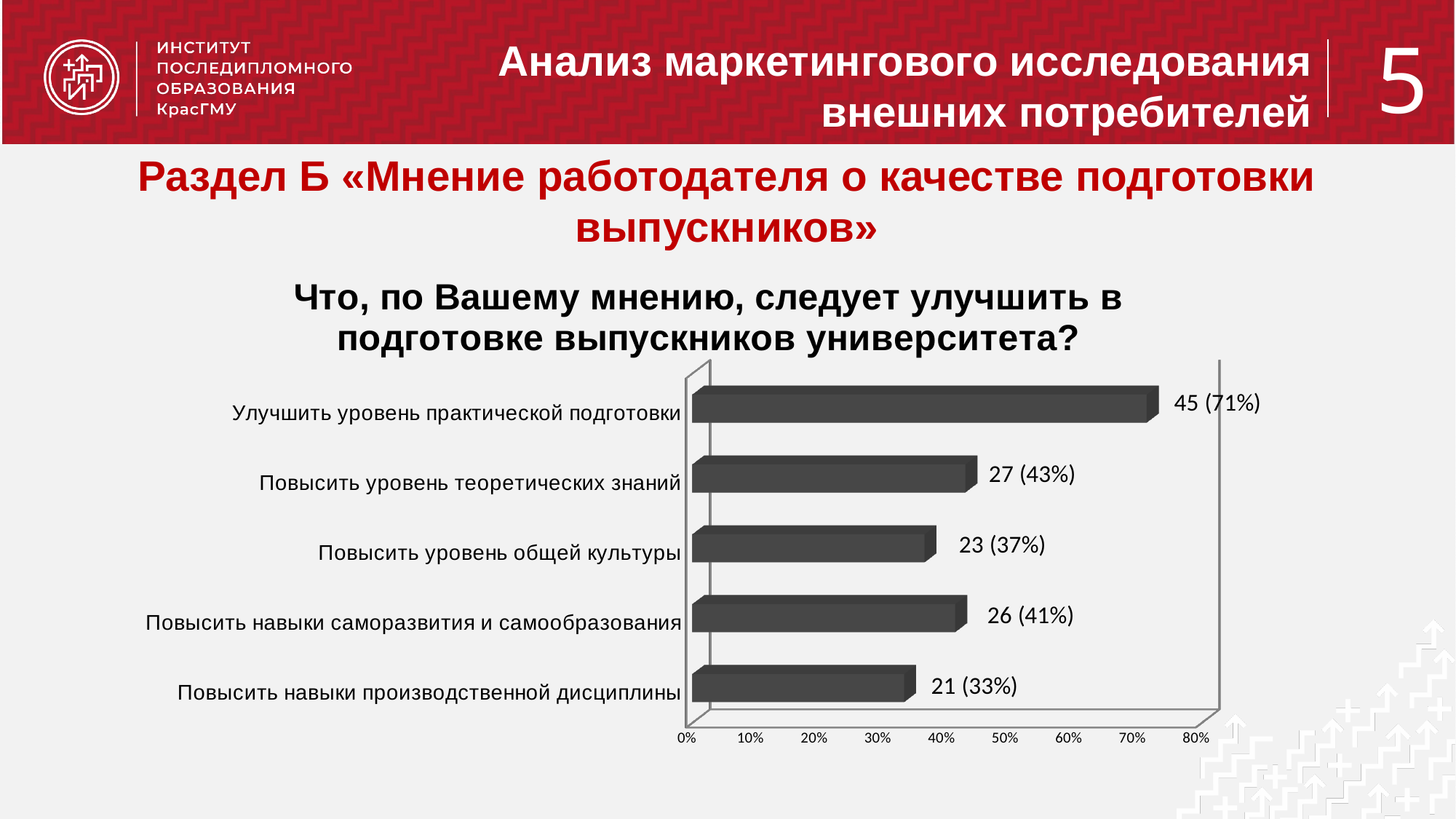
How many respondents chose «Повысить навыки саморазвития и самообразования»? 26 What is the maximum value shown on the percentage axis? 80% What is the difference in respondent counts between «Улучшить уровень практической подготовки» and «Повысить уровень теоретических знаний»? 18 How many categories are shown in the chart? 5 What is the data label for «Повысить навыки производственной дисциплины»? 21 (33%) Which category has the highest value? Улучшить уровень практической подготовки What is the data label for «Улучшить уровень практической подготовки»? 45 (71%) What percentage is shown for «Повысить уровень общей культуры»? 37% Which is larger: the value for «Повысить уровень теоретических знаний» or for «Повысить навыки саморазвития и самообразования»? Повысить уровень теоретических знаний Which category has the lowest value? Повысить навыки производственной дисциплины What type of chart is shown on the slide? bar chart Is the value for «Повысить навыки производственной дисциплины» greater or less than 40%? less